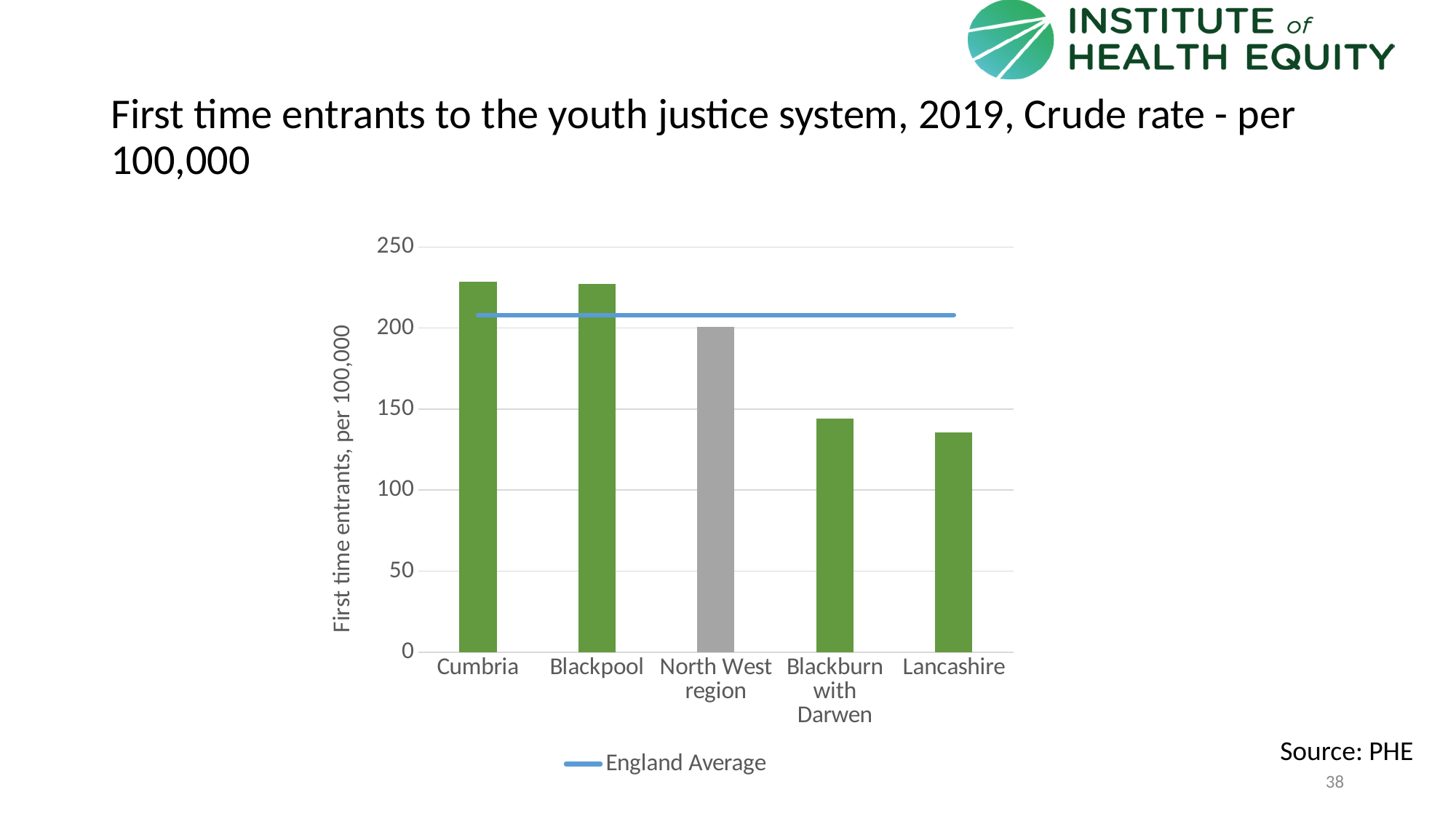
How many categories are shown on the x axis of the chart? 5 Which is larger, the value for Blackpool or the value for Blackburn with Darwen? Blackpool What is the label of the y axis? First time entrants, per 100,000 Is the value for Blackburn with Darwen greater or less than 150? less Is the England Average line greater or less than 200? greater Which category has the lowest value in the chart? Lancashire How many series does the legend list? 1 Do the bar values generally rise or fall from left to right across the x axis? fall What kind of chart is shown on the slide? combination bar and line chart Is the value for Lancashire greater or less than 150? less Which is larger, the value for North West region or the value for Lancashire? North West region